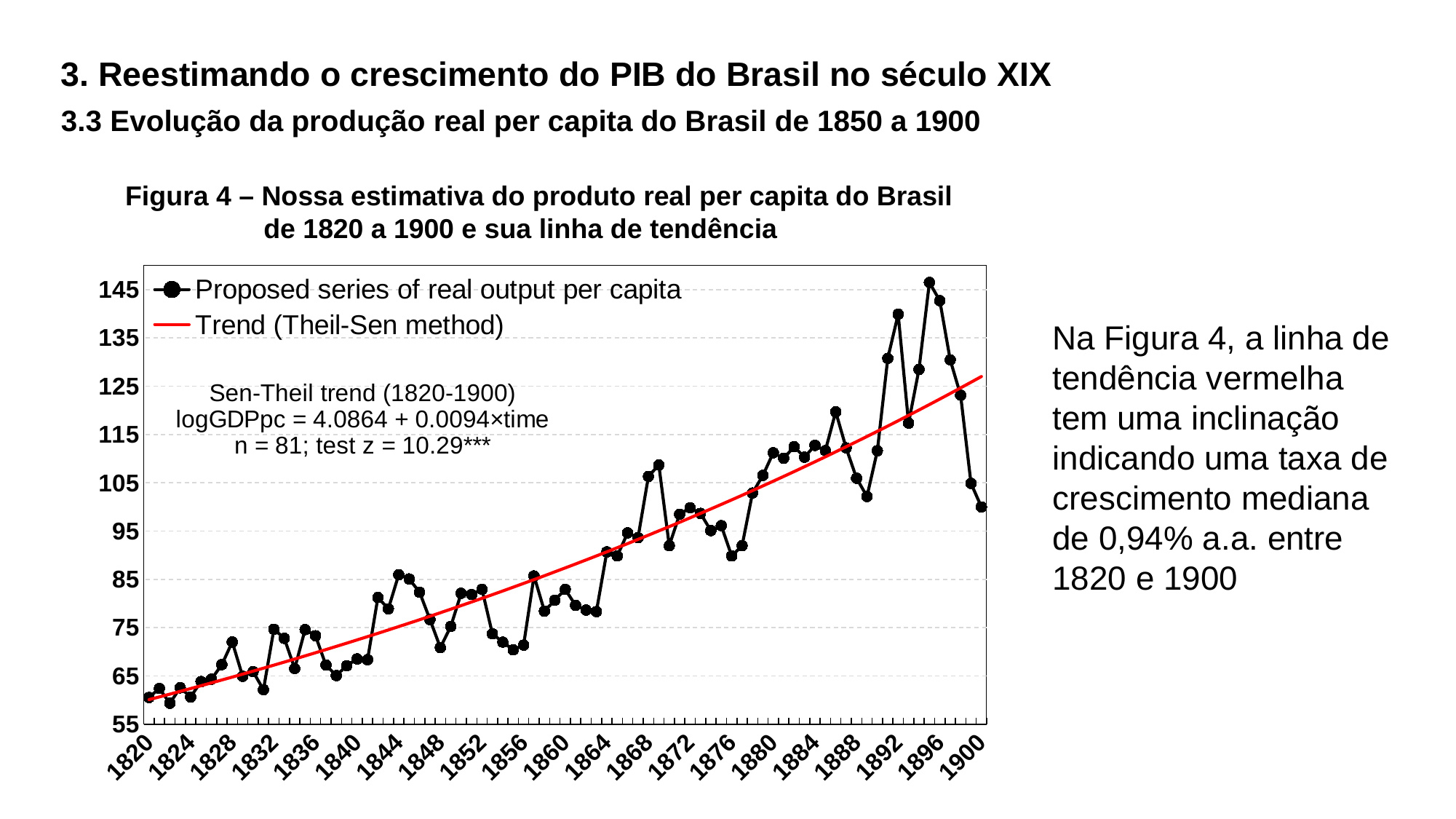
Is the value of the proposed series in 1848 greater or less than 75? less Is the value of the proposed series in 1888 greater or less than 115? less What are the two series named in the legend of Figura 4? Proposed series of real output per capita; Trend (Theil-Sen method) What kind of chart is shown in Figura 4? line chart Is the value of the proposed series in 1892 greater or less than 135? greater Which is larger, the proposed series value in 1892 or in 1900? 1892 How many series does the legend of Figura 4 list? 2 According to the annotation on the chart, how many observations (n) does the Sen-Theil trend use? 81 Does the proposed series of real output per capita generally rise or fall from 1820 to 1900? rise What colour is the trend line in Figura 4? red In which year does the proposed series of real output per capita reach its highest value? 1895